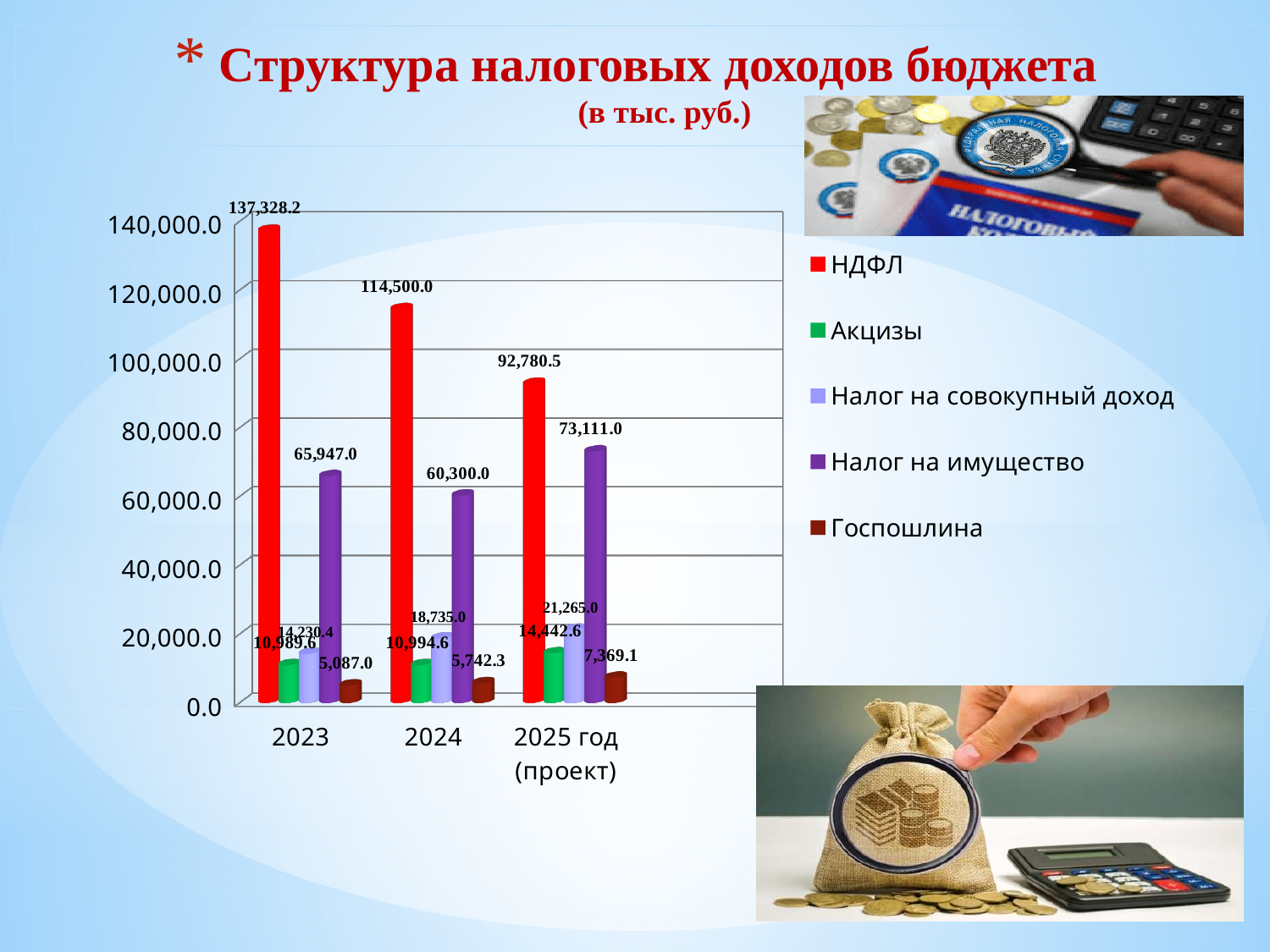
How many year categories are shown on the x axis? 3 Which is larger: Налог на имущество in 2023 or Налог на имущество in 2024? Налог на имущество in 2023 Does НДФЛ rise or fall from 2023 to 2025 год (проект)? fall How many series does the legend list? 5 What is the value of НДФЛ for 2023? 137,328.2 In which year is НДФЛ the highest? 2023 What is the value of Госпошлина for 2024? 5,742.3 What is the value of Налог на совокупный доход for 2024? 18,735.0 What kind of chart is shown on the slide? bar chart What is the difference between НДФЛ in 2023 and НДФЛ in 2024? 22,828.2 Which series has the lowest value in 2025 год (проект)? Госпошлина What is the value of Налог на имущество for 2025 год (проект)? 73,111.0